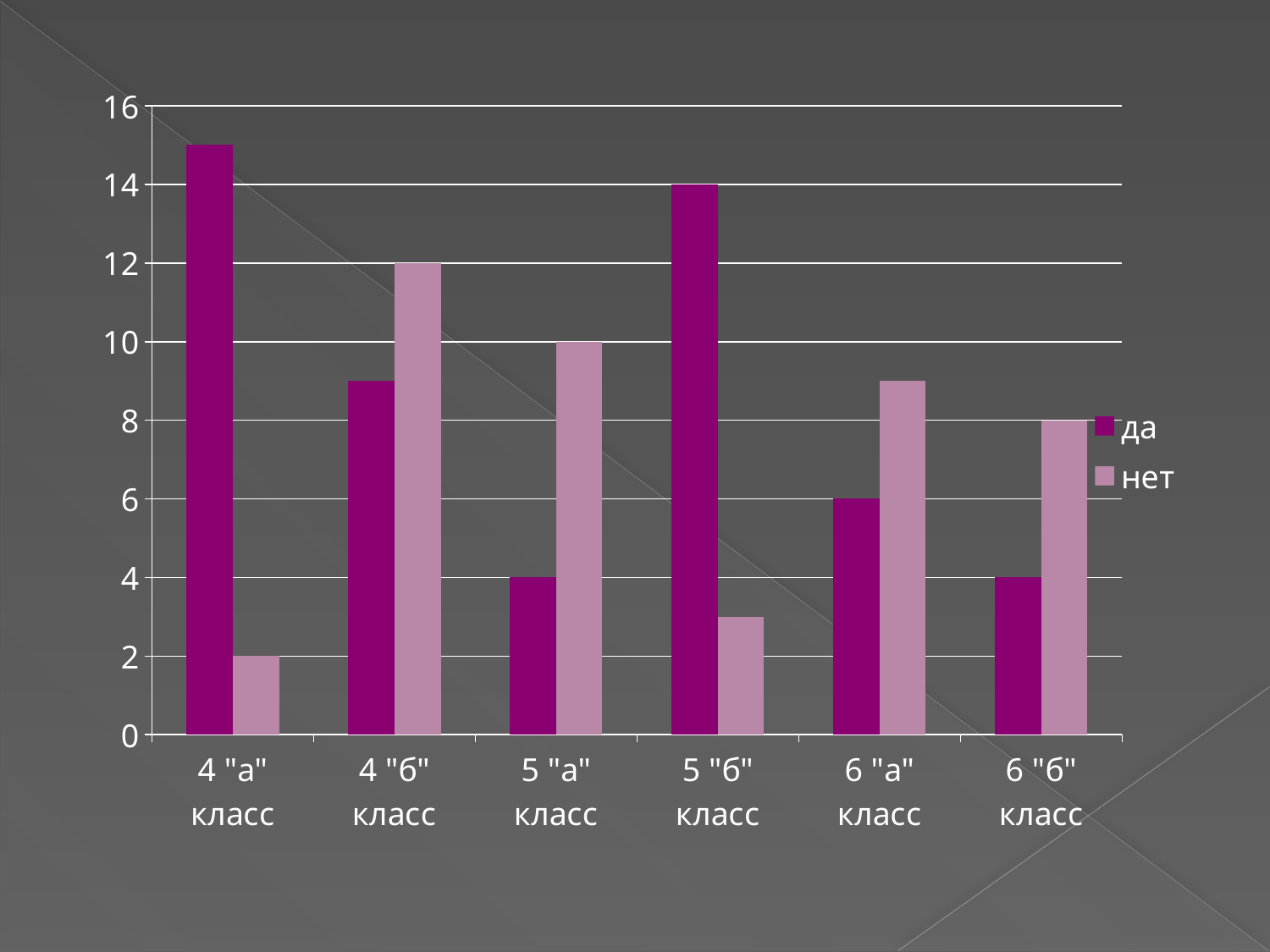
What is the difference between "нет" and "да" for 6 "б" класс? 4 What kind of chart is shown on the slide? bar chart How many classes (categories) are shown on the x axis? 6 What is the value of "нет" for 5 "а" класс? 10 Is the value of "да" for 4 "а" класс greater or less than 14? greater Which class has the lowest "нет" value? 4 "а" класс For 5 "а" класс, which is larger: "да" or "нет"? нет How many series does the legend list? 2 Is the value of "нет" for 5 "б" класс greater or less than 4? less What is the value of "да" for 5 "б" класс? 14 What is the value of "да" for 6 "а" класс? 6 What is the value of "нет" for 4 "б" класс? 12